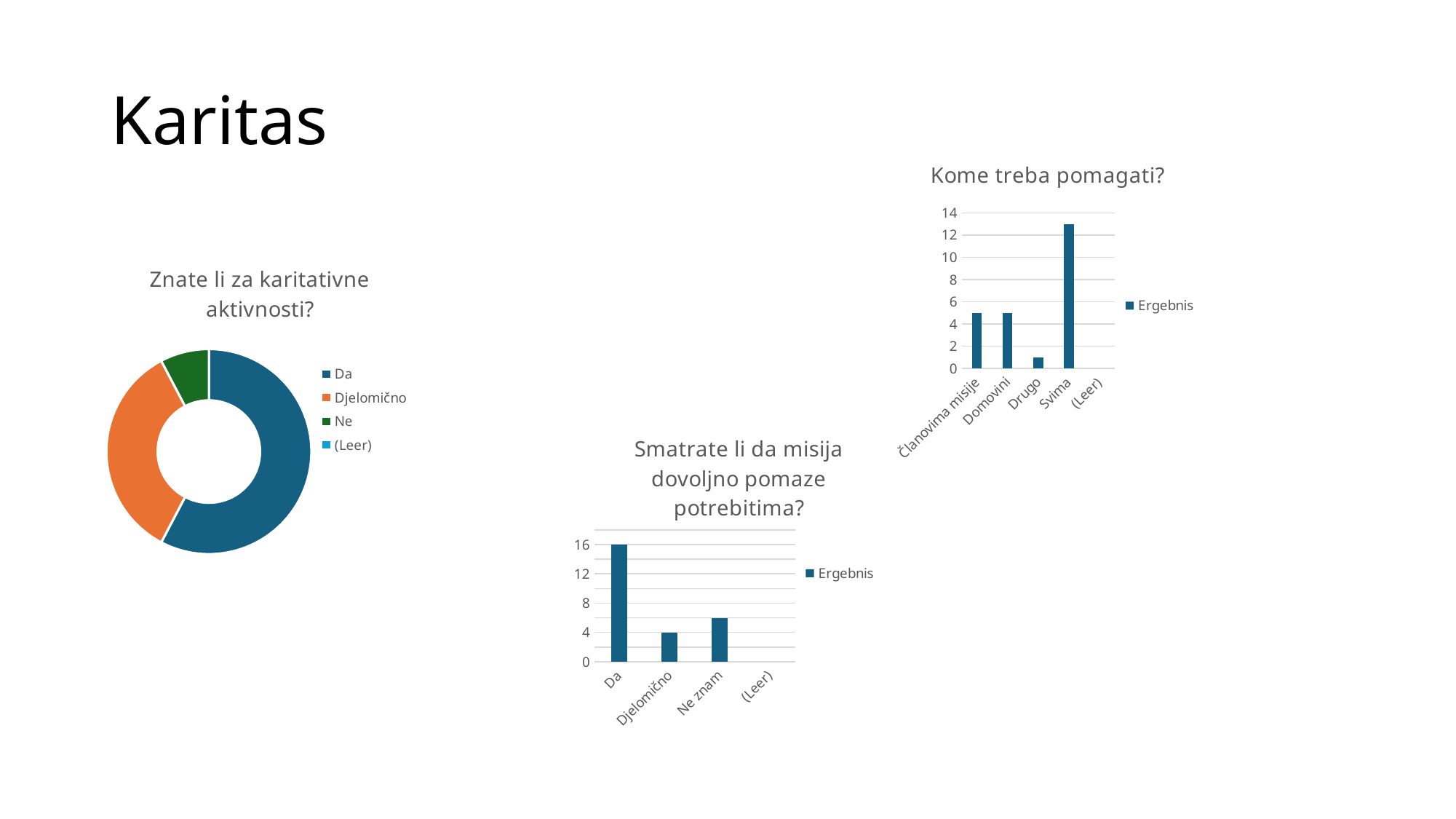
In the chart 'Kome treba pomagati?', is the value for Svima greater or less than 12? greater What kind of chart is 'Znate li za karitativne aktivnosti?'? doughnut chart In the chart 'Smatrate li da misija dovoljno pomaze potrebitima?', is the value for Ne znam greater or less than 8? less In the chart 'Smatrate li da misija dovoljno pomaze potrebitima?', what is the value for Da? 16 In the chart 'Znate li za karitativne aktivnosti?', which slice is larger, Djelomično or Ne? Djelomično How many entries does the legend of 'Znate li za karitativne aktivnosti?' list? 4 In the chart 'Kome treba pomagati?', is the value for Drugo greater or less than 2? less In the chart 'Znate li za karitativne aktivnosti?', which category has the largest slice? Da In the chart 'Kome treba pomagati?', which category has the highest value? Svima How many categories are shown on the x axis of the chart 'Kome treba pomagati?'? 5 In the chart 'Smatrate li da misija dovoljno pomaze potrebitima?', what is the value for Djelomično? 4 In the chart 'Smatrate li da misija dovoljno pomaze potrebitima?', what is the difference between the values for Da and Djelomično? 12